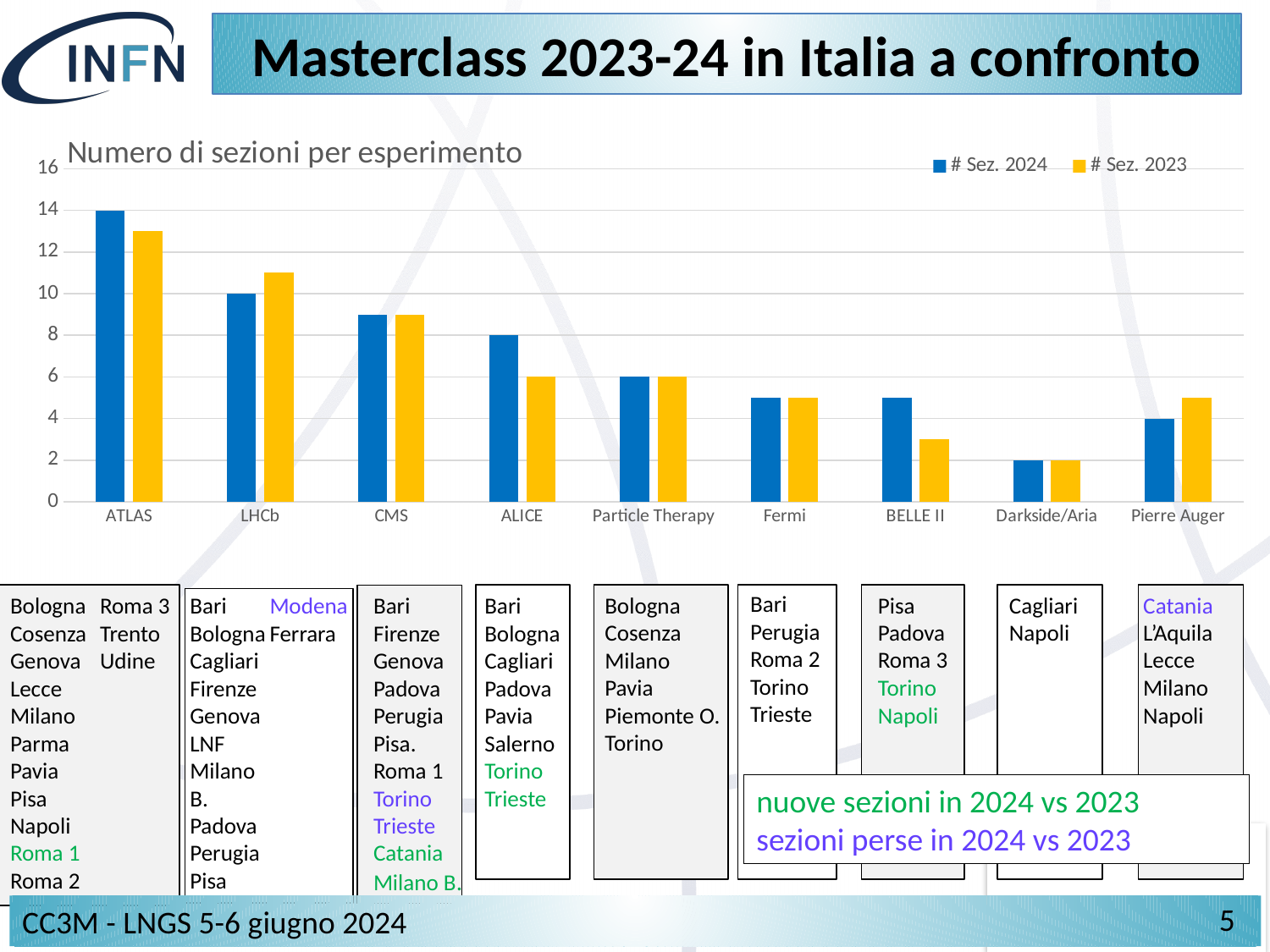
Which experiment has the lowest value for # Sez. 2023? Darkside/Aria How many experiments are shown on the x axis of the chart? 9 What is the value of # Sez. 2023 for Particle Therapy? 6 Is the value of # Sez. 2023 for BELLE II greater or less than 4? less What is the value of # Sez. 2024 for LHCb? 10 How many series does the legend of the chart list? 2 What is the value of # Sez. 2024 for ALICE? 8 For BELLE II, which is larger: # Sez. 2024 or # Sez. 2023? # Sez. 2024 What is the value of # Sez. 2024 for ATLAS? 14 Which experiment has the highest value for # Sez. 2024? ATLAS What type of chart is shown on the slide? bar chart What is the difference between # Sez. 2024 and # Sez. 2023 for ALICE? 2